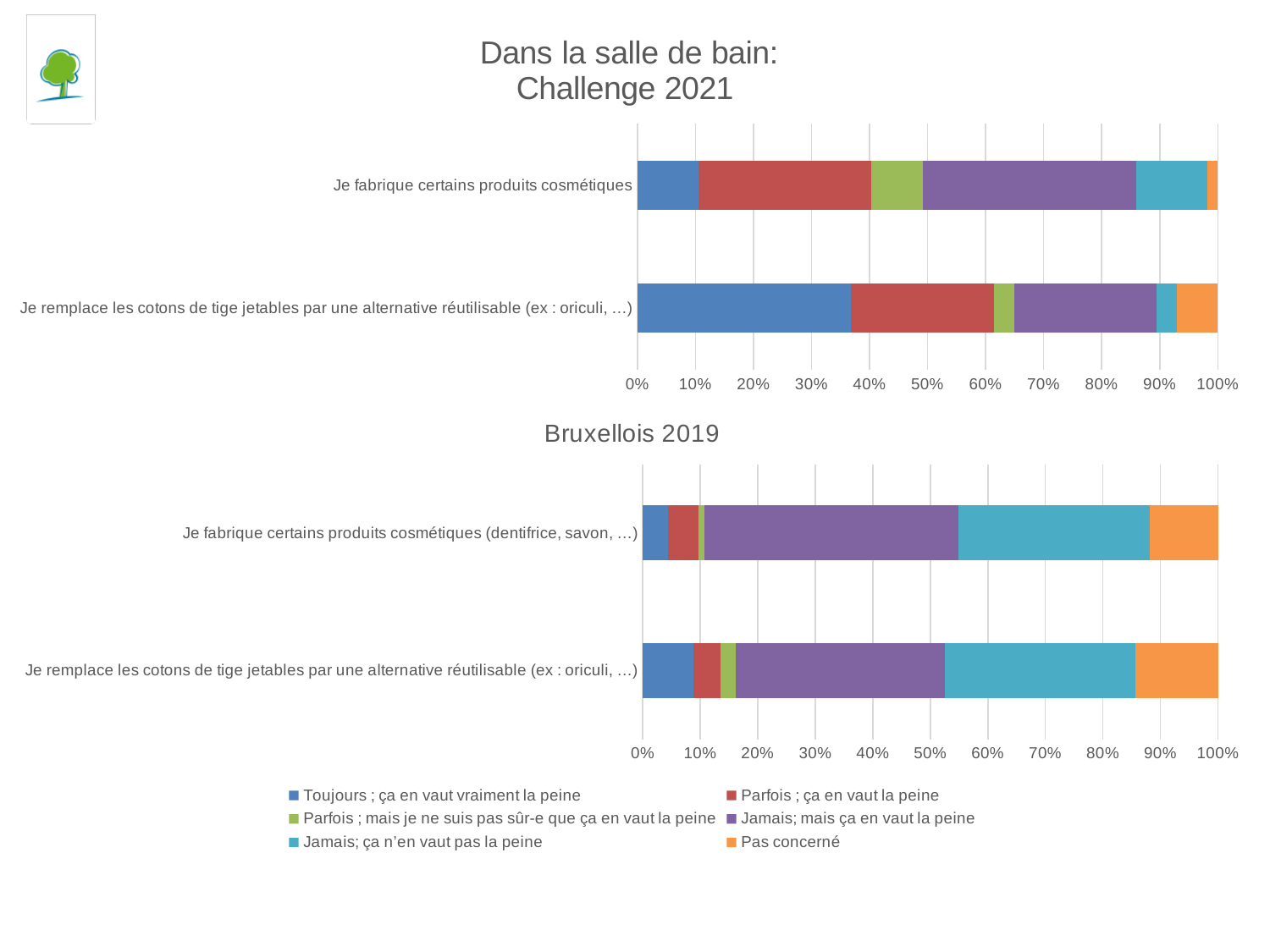
What kind of chart is the top chart titled "Dans la salle de bain: Challenge 2021"? Stacked bar chart In the top chart (Challenge 2021), which category has the larger "Jamais; mais ça en vaut la peine" segment? Je fabrique certains produits cosmétiques Which legend entry is shown in orange? Pas concerné How many series does the legend at the bottom of the slide list? 6 In the top chart (Challenge 2021), is the "Toujours ; ça en vaut vraiment la peine" segment for "Je remplace les cotons de tige jetables par une alternative réutilisable" greater or less than 30%? greater In the bottom chart (Bruxellois 2019), is the "Pas concerné" segment for "Je remplace les cotons de tige jetables par une alternative réutilisable" greater or less than 20%? less In the bottom chart (Bruxellois 2019), is the "Jamais; mais ça en vaut la peine" segment for "Je fabrique certains produits cosmétiques (dentifrice, savon, …)" greater or less than 30%? greater In the bottom chart (Bruxellois 2019), which category has the larger "Toujours ; ça en vaut vraiment la peine" segment? Je remplace les cotons de tige jetables par une alternative réutilisable (ex : oriculi, …) What is the title of the top chart on the slide? Dans la salle de bain: Challenge 2021 In the top chart (Challenge 2021), which category has the larger "Toujours ; ça en vaut vraiment la peine" segment? Je remplace les cotons de tige jetables par une alternative réutilisable (ex : oriculi, …) How many categories are plotted in the bottom chart titled "Bruxellois 2019"? 2